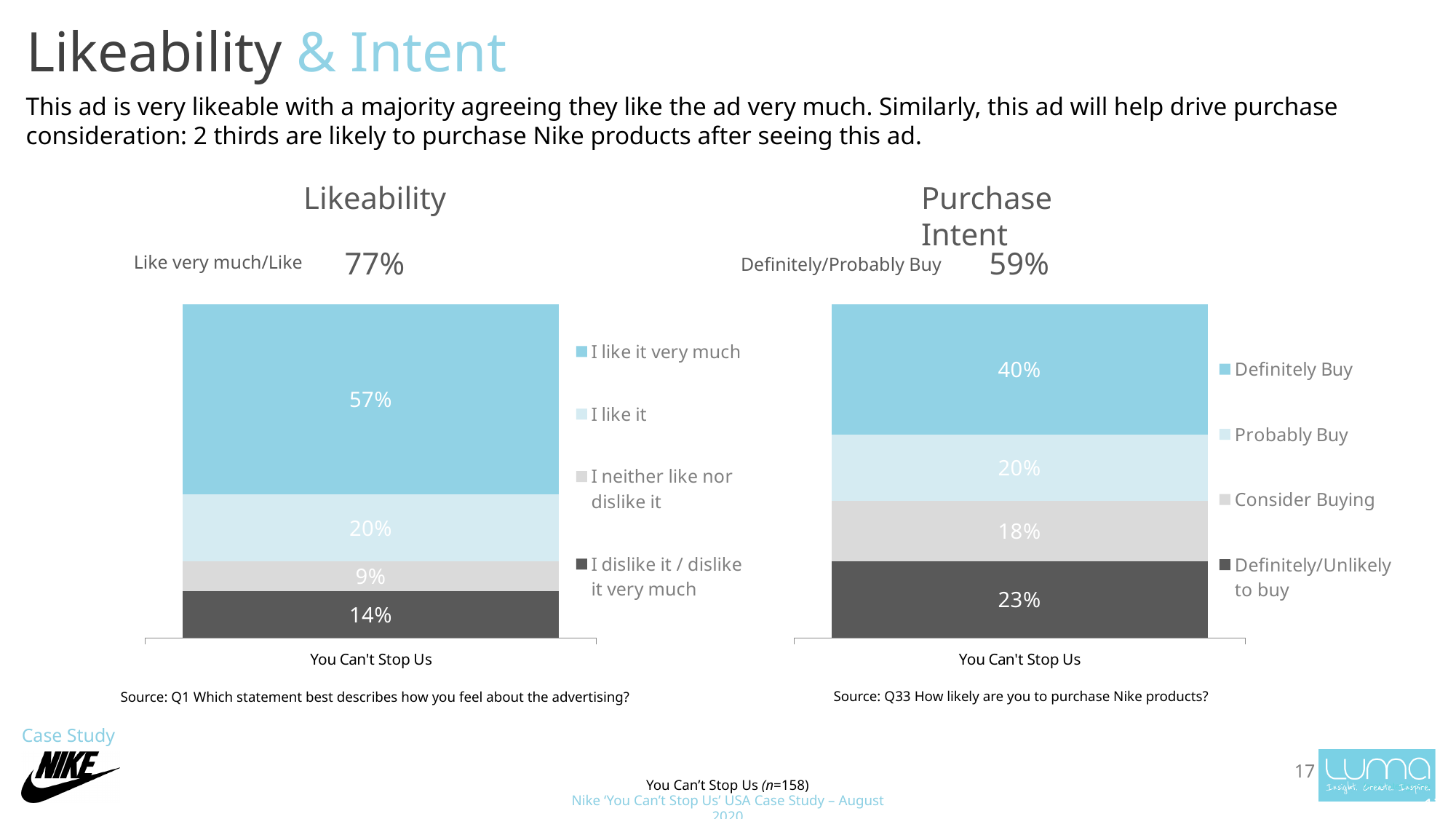
In the Purchase Intent chart, what percentage said "Consider Buying"? 18% In the Purchase Intent chart, what percentage said "Definitely Buy"? 40% In the Likeability chart, which is larger: "I like it" or "I dislike it / dislike it very much"? I like it In the Purchase Intent chart, which response has the largest share? Definitely Buy In the Likeability chart, which response has the smallest share? I neither like nor dislike it In the Likeability chart, what percentage of respondents said "I like it very much"? 57% How many series does the legend of the Purchase Intent chart list? 4 In the Likeability chart, what percentage said "I dislike it / dislike it very much"? 14% What is the combined "Definitely/Probably Buy" figure shown above the Purchase Intent chart? 59% What type of chart is the Likeability chart? Stacked bar chart In the Purchase Intent chart, what is the difference between "Definitely Buy" and "Definitely/Unlikely to buy"? 17% In the Likeability chart, what is the total of the stacked bar for "You Can't Stop Us"? 100%